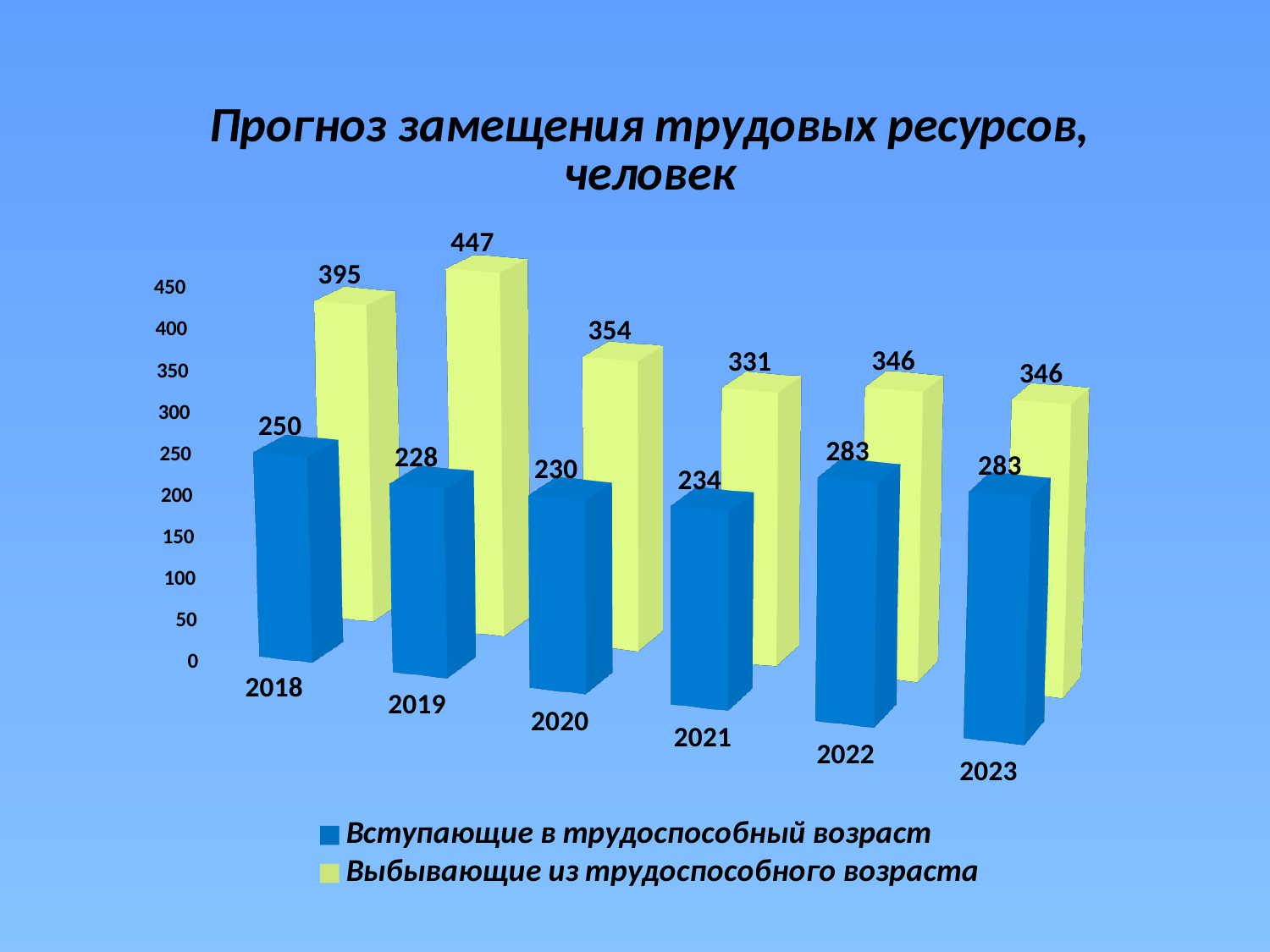
How many years are shown on the x axis? 6 What is the difference between "Выбывающие из трудоспособного возраста" in 2018 and in 2020? 41 How many series does the legend list? 2 What is the difference between "Выбывающие из трудоспособного возраста" and "Вступающие в трудоспособный возраст" in 2019? 219 In which year is "Вступающие в трудоспособный возраст" lowest? 2019 Which is larger in 2022: "Вступающие в трудоспособный возраст" or "Выбывающие из трудоспособного возраста"? Выбывающие из трудоспособного возраста What is the title of the chart? Прогноз замещения трудовых ресурсов, человек In which year is "Выбывающие из трудоспособного возраста" highest? 2019 What is the value for "Вступающие в трудоспособный возраст" in 2018? 250 What kind of chart is shown on the slide? Bar chart What is the value for "Выбывающие из трудоспособного возраста" in 2019? 447 What is the value for "Вступающие в трудоспособный возраст" in 2021? 234